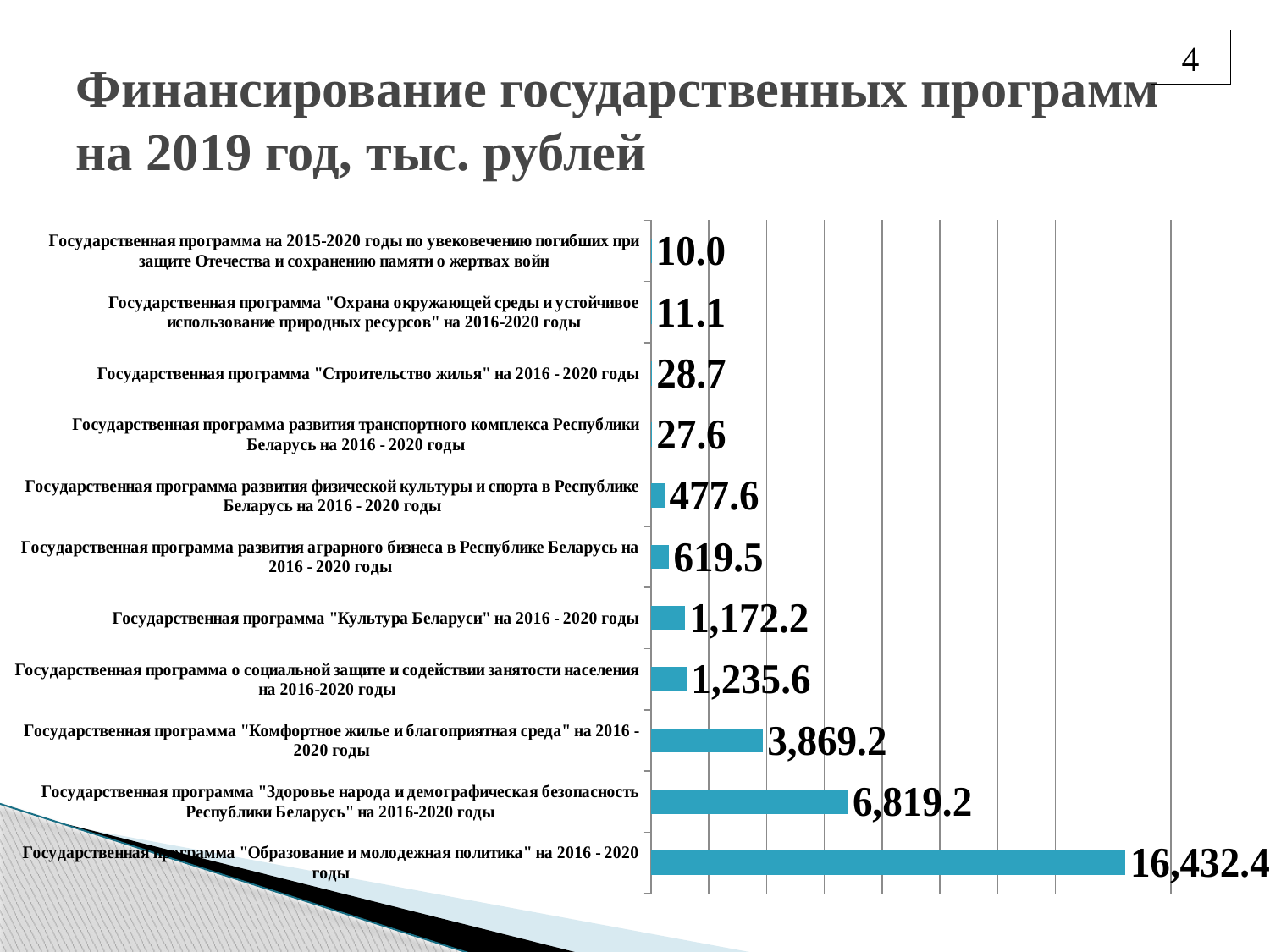
What type of chart is shown on the slide? Bar chart Which state program has the lowest funding on the chart? Государственная программа на 2015-2020 годы по увековечению погибших при защите Отечества и сохранению памяти о жертвах войн What is the title of the slide? Финансирование государственных программ на 2019 год, тыс. рублей What is the difference between the funding for the agrarian business program (развития аграрного бизнеса) and the physical culture and sport program (развития физической культуры и спорта)? 141.9 What is the funding value for the state program "Культура Беларуси" на 2016 - 2020 годы? 1,172.2 What is the funding value for the state program "Образование и молодежная политика" на 2016 - 2020 годы? 16,432.4 What is the funding value for the state program "Здоровье народа и демографическая безопасность Республики Беларусь" на 2016-2020 годы? 6,819.2 What is the difference between the funding for "Образование и молодежная политика" and "Здоровье народа и демографическая безопасность Республики Беларусь"? 9,613.2 How many state programs are shown on the chart? 11 What is the funding value for the state program "Строительство жилья" на 2016 - 2020 годы? 28.7 Which has larger funding: the program "Комфортное жилье и благоприятная среда" or the program о социальной защите и содействии занятости населения? Государственная программа "Комфортное жилье и благоприятная среда" на 2016 - 2020 годы Which state program has the highest funding on the chart? Государственная программа "Образование и молодежная политика" на 2016 - 2020 годы